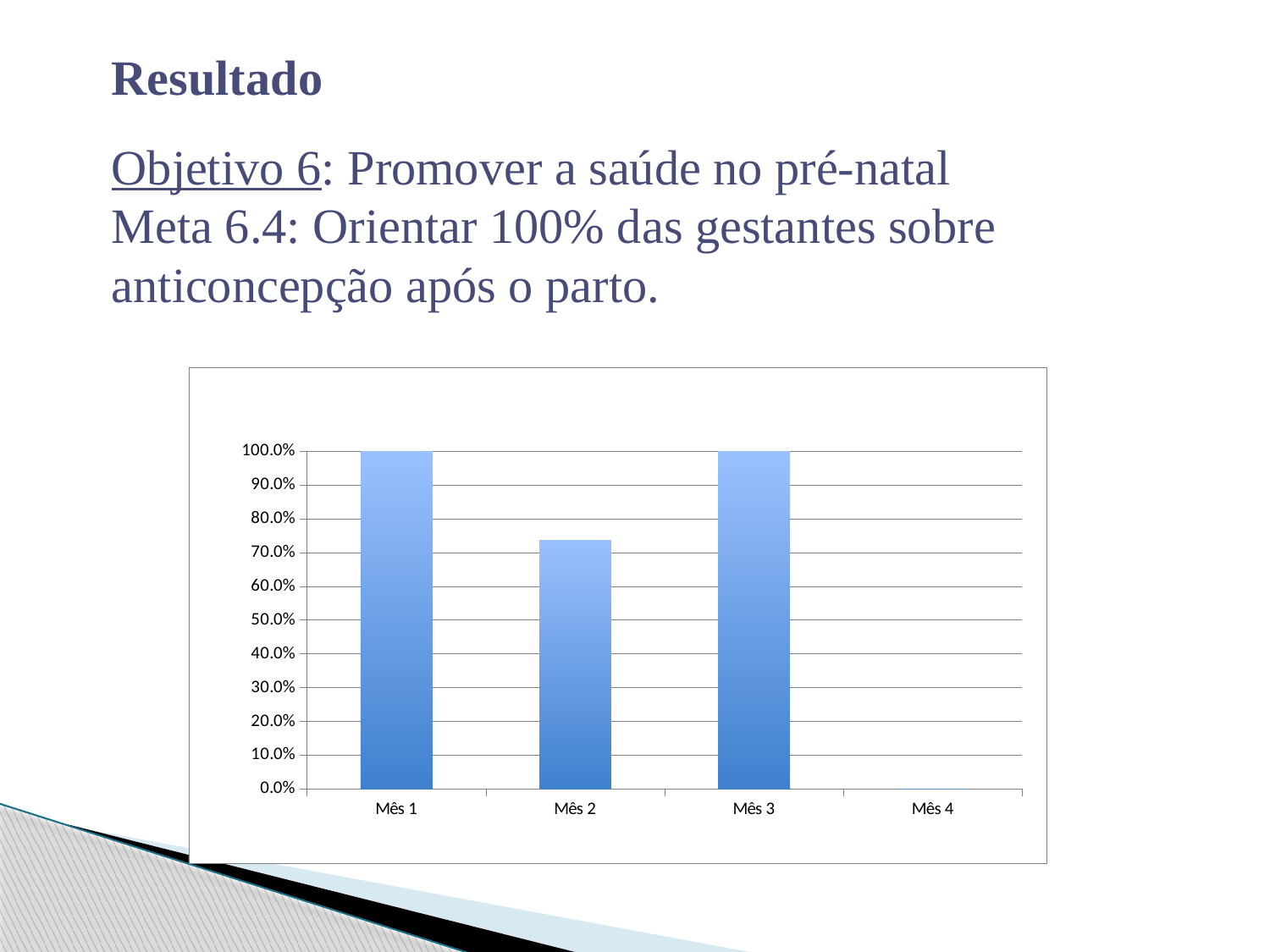
Is the value for Mês 4 greater or less than 10.0%? less What kind of chart is shown on the slide? bar chart Is the value for Mês 2 greater or less than 80.0%? less What is the highest value shown on the y axis of the chart? 100.0% Is the value for Mês 2 greater or less than 70.0%? greater What is the value for Mês 1? 100.0% Which is larger, the value for Mês 2 or the value for Mês 3? Mês 3 What is the difference between the values for Mês 1 and Mês 3? 0.0% What is the value for Mês 3? 100.0% Which month has the lowest value in the chart? Mês 4 How many categories (months) are shown on the x axis of the chart? 4 Which is larger, the value for Mês 1 or the value for Mês 2? Mês 1